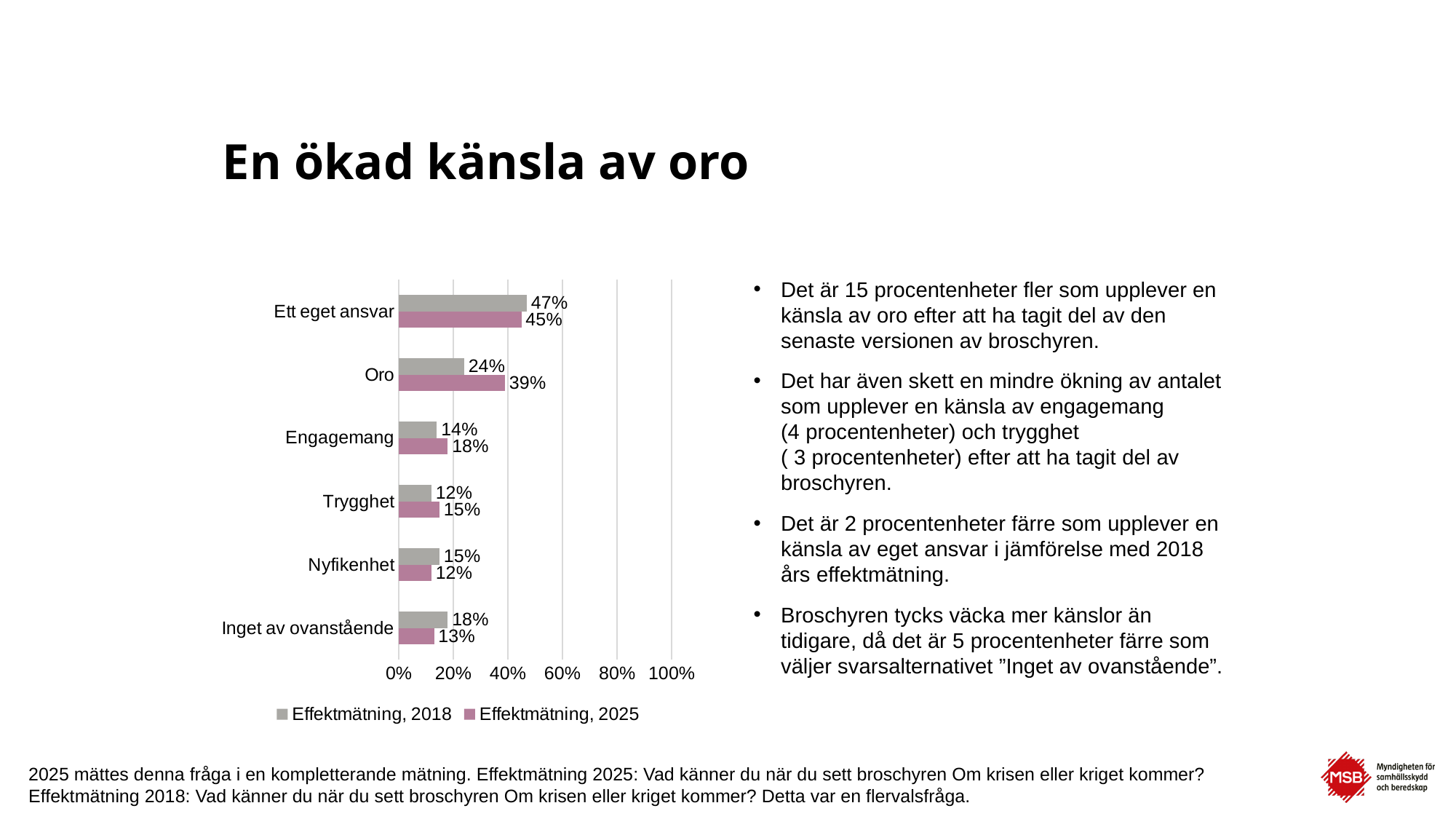
How many categories are shown on the chart? 6 What kind of chart is shown on the slide? Bar chart Is the value for Ett eget ansvar in the Effektmätning, 2025 series greater or less than 40%? greater Which category has the highest value in the Effektmätning, 2025 series? Ett eget ansvar What is the value for Oro in the Effektmätning, 2025 series? 39% How many series does the legend list? 2 What is the difference between the 2025 and 2018 values for Oro? 15 percentage points Which category has the lowest value in the Effektmätning, 2018 series? Trygghet What colour are the bars for the Effektmätning, 2025 series? Pink/purple What is the value for Trygghet in the Effektmätning, 2025 series? 15% What is the value for Ett eget ansvar in the Effektmätning, 2018 series? 47% For Nyfikenhet, which series has the larger value, Effektmätning, 2018 or Effektmätning, 2025? Effektmätning, 2018